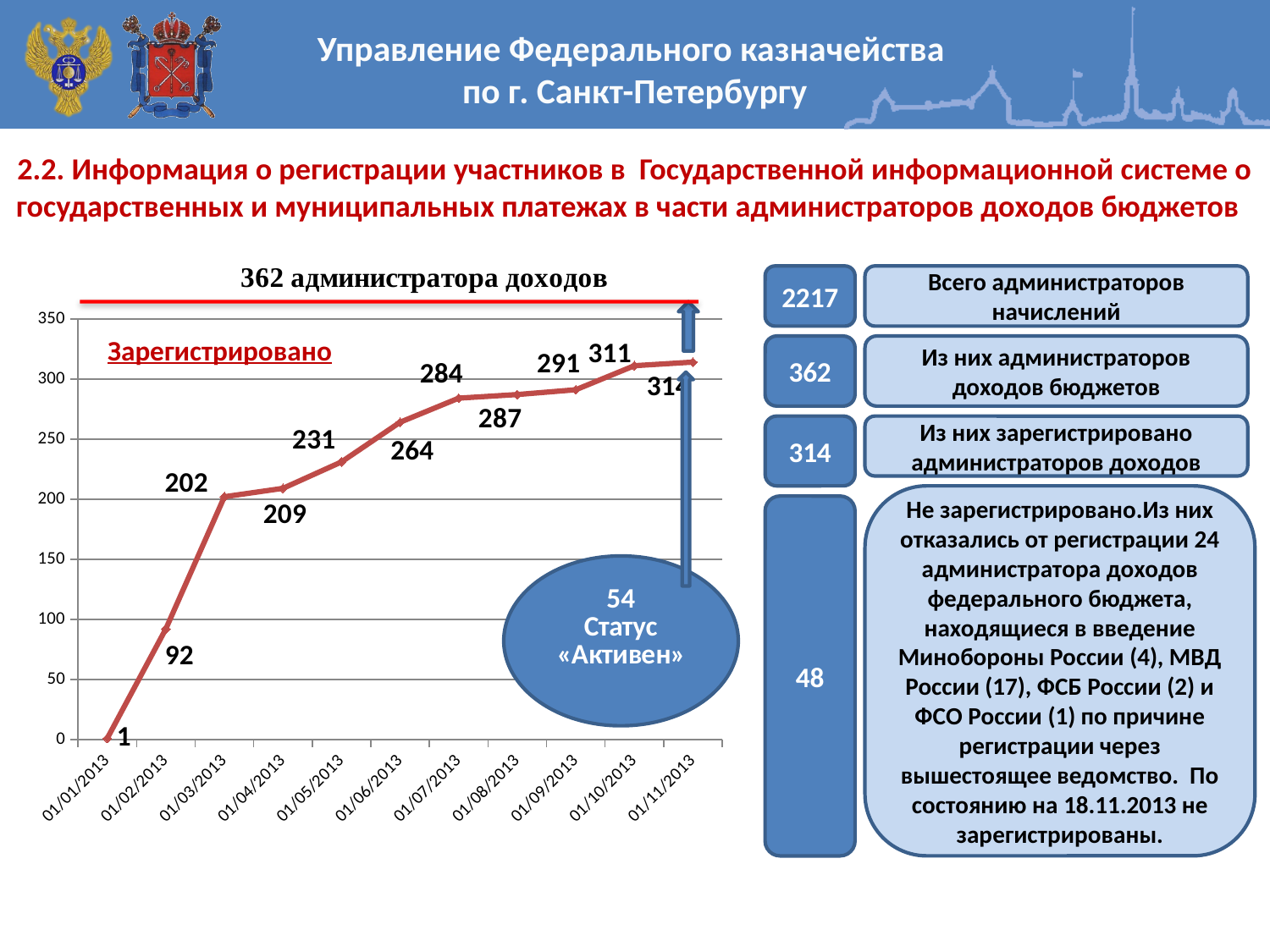
How many data points are plotted on the line? 11 What is the value for 01/06/2013? 264 What type of chart is shown on the slide? line chart What is the difference between the values for 01/07/2013 and 01/06/2013? 20 What is the value for 01/03/2013? 202 What is the value for 01/02/2013? 92 Which date has the lowest value on the chart? 01/01/2013 What is the value for 01/11/2013? 314 Which is larger, the value for 01/05/2013 or the value for 01/04/2013? 01/05/2013 Which date has the highest value on the chart? 01/11/2013 Do the values rise or fall from 01/01/2013 to 01/11/2013? rise What is the difference between the values for 01/03/2013 and 01/02/2013? 110